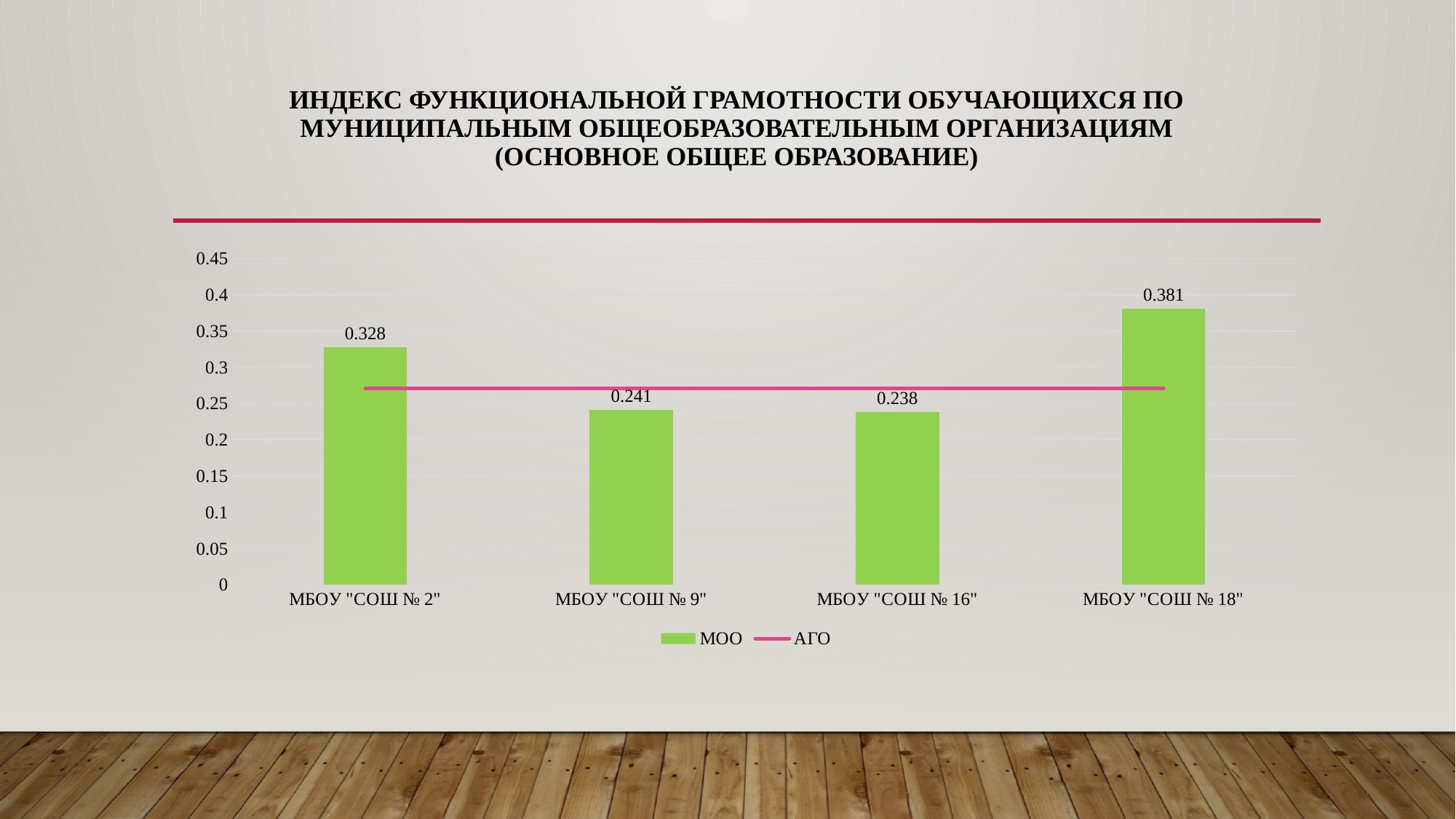
What kind of chart is shown on the slide? bar chart with a line What is the МОО value for МБОУ "СОШ № 2"? 0.328 What is the МОО value for МБОУ "СОШ № 9"? 0.241 What is the МОО value for МБОУ "СОШ № 16"? 0.238 Which is larger, the МОО value for МБОУ "СОШ № 2" or for МБОУ "СОШ № 9"? МБОУ "СОШ № 2" What is the difference between the МОО values for МБОУ "СОШ № 18" and МБОУ "СОШ № 2"? 0.053 Is the АГО line value greater or less than 0.3? less How many series does the legend list? 2 How many schools are shown on the x axis? 4 What colour are the МОО bars? green What is the МОО value for МБОУ "СОШ № 18"? 0.381 Which school has the highest МОО value? МБОУ "СОШ № 18"